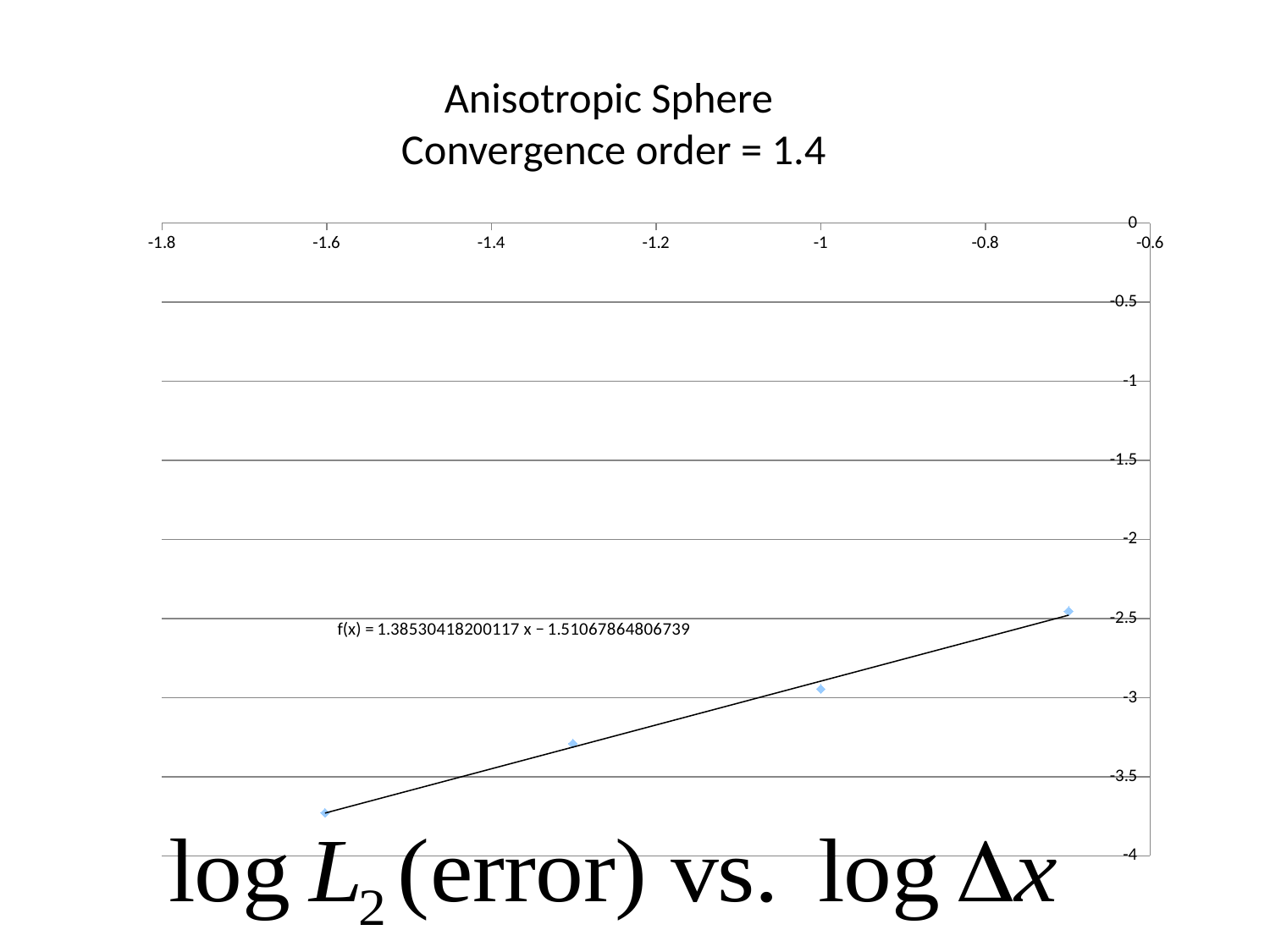
What is the trendline equation displayed on the chart? f(x) = 1.38530418200117 x − 1.51067864806739 Which data point has the lowest y value on the chart? The leftmost point (at x = -1.6) Is the y value of the rightmost data point greater or less than -3? greater How many data points are plotted on the chart? 4 What is the title of the chart? Anisotropic Sphere Convergence order = 1.4 Is the y value of the leftmost data point (at x = -1.6) greater or less than -3.5? less What type of chart is shown on the slide? Scatter chart Which data point has the highest y value, the leftmost or the rightmost? The rightmost What is the lowest value shown on the y axis? -4 Do the plotted values rise or fall as the x value increases from -1.8 toward -0.6? Rise Is the y value of the second data point from the left greater or less than -3? less